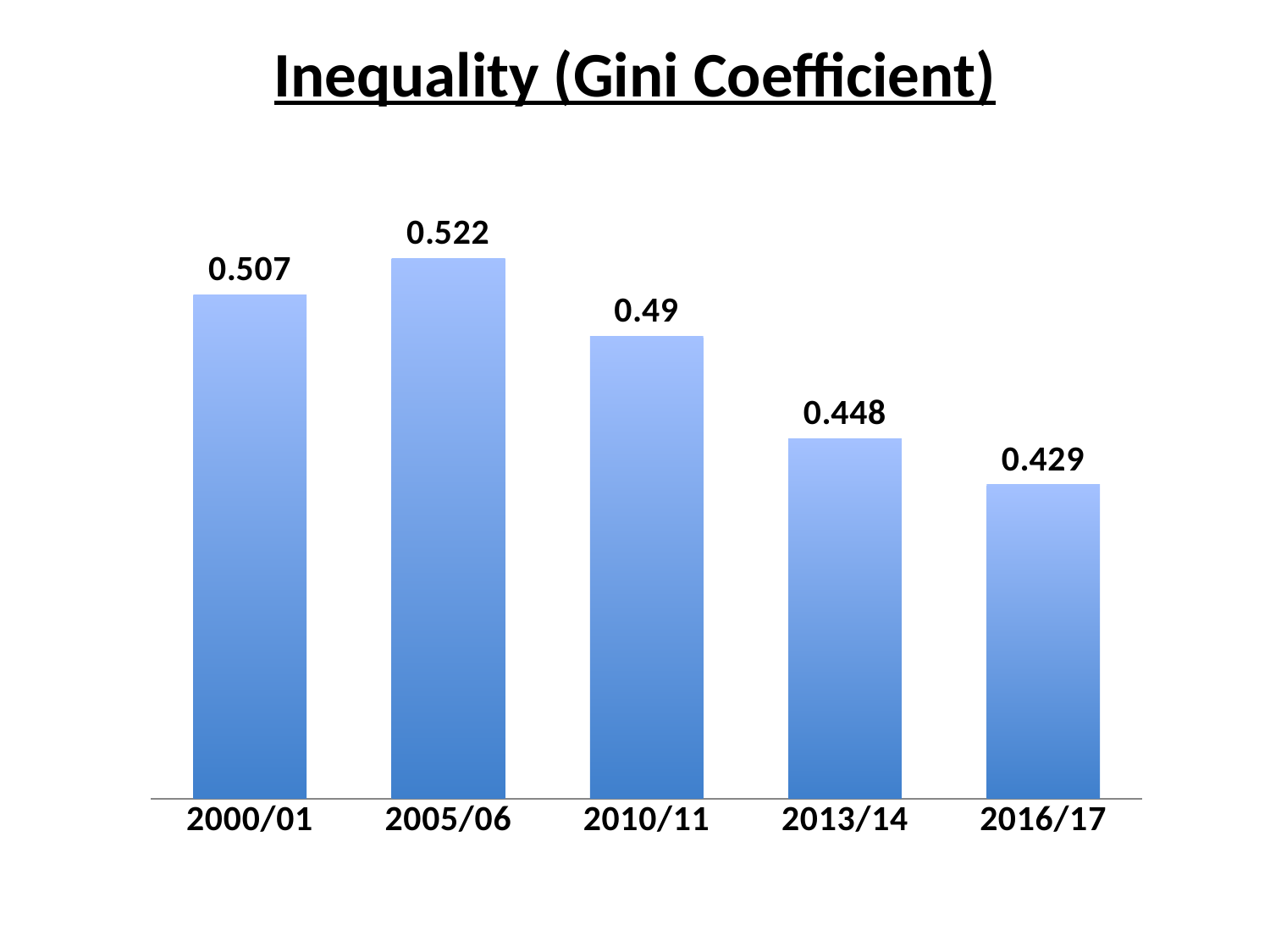
What is the Gini coefficient for 2016/17? 0.429 Does the Gini coefficient rise or fall from 2005/06 to 2016/17? Fall What is the difference between the Gini coefficient in 2005/06 and in 2016/17? 0.093 Which year has the lowest Gini coefficient? 2016/17 What is the difference between the Gini coefficient in 2000/01 and in 2013/14? 0.059 Which year has the highest Gini coefficient? 2005/06 Which is larger, the Gini coefficient for 2000/01 or for 2010/11? 2000/01 How many years are shown on the chart? 5 What is the Gini coefficient for 2010/11? 0.49 What is the title of the chart? Inequality (Gini Coefficient) What is the Gini coefficient for 2000/01? 0.507 What kind of chart is shown on the slide? Bar chart